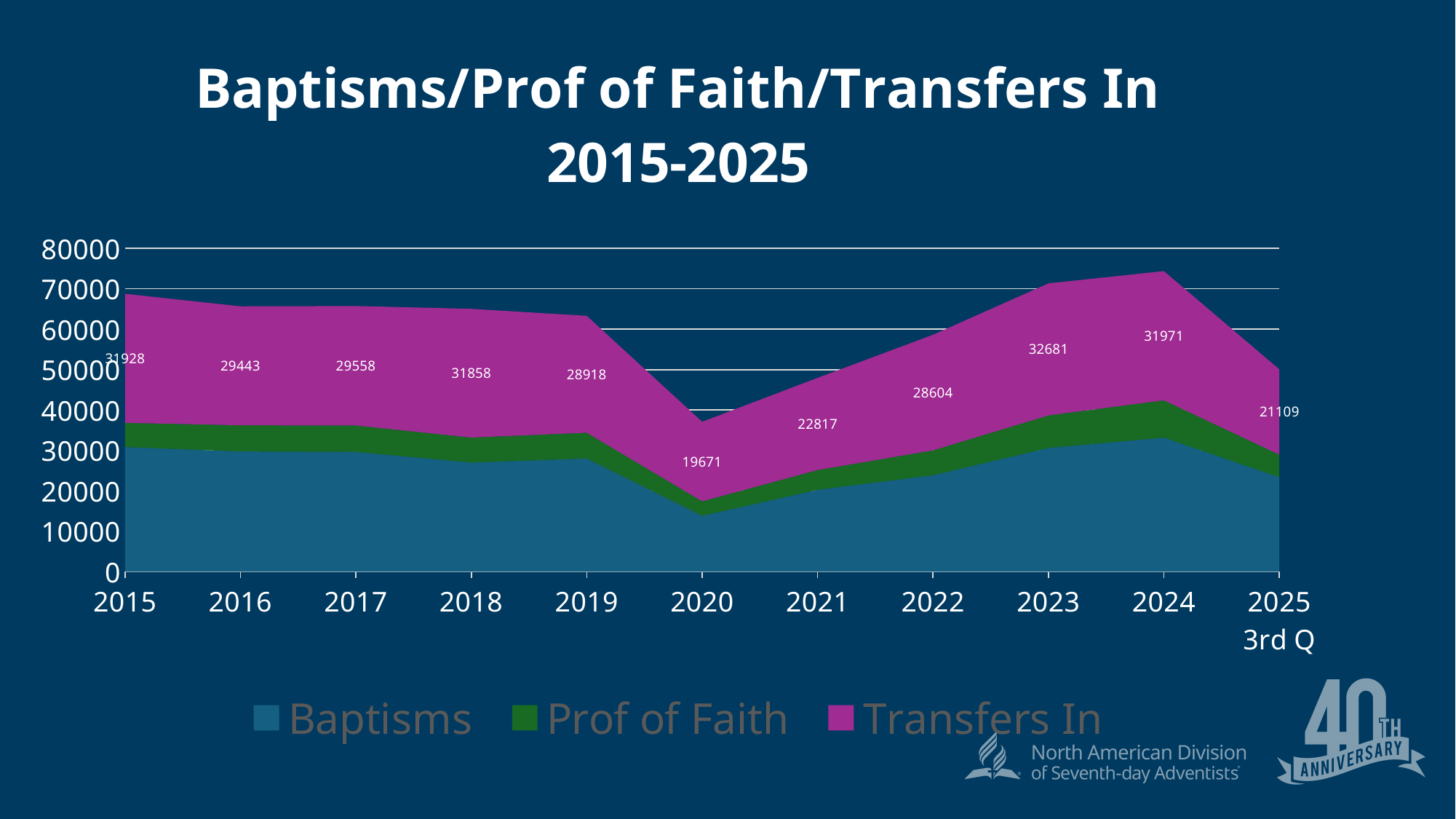
What is the Transfers In value for 2020? 19671 In which year is the Transfers In value lowest? 2020 What is the Transfers In value for 2023? 32681 Is the combined total of all three series in 2024 greater or less than 70000? greater What kind of chart is shown on the slide? Stacked area chart How many series does the legend list? 3 In which year is the Transfers In value highest? 2023 Is the Baptisms value for 2020 greater or less than 20000? less How many years are shown on the x axis? 11 What is the Transfers In value for 2025 3rd Q? 21109 What is the difference between the Transfers In values for 2023 and 2020? 13010 Which year has the larger Transfers In value, 2018 or 2019? 2018